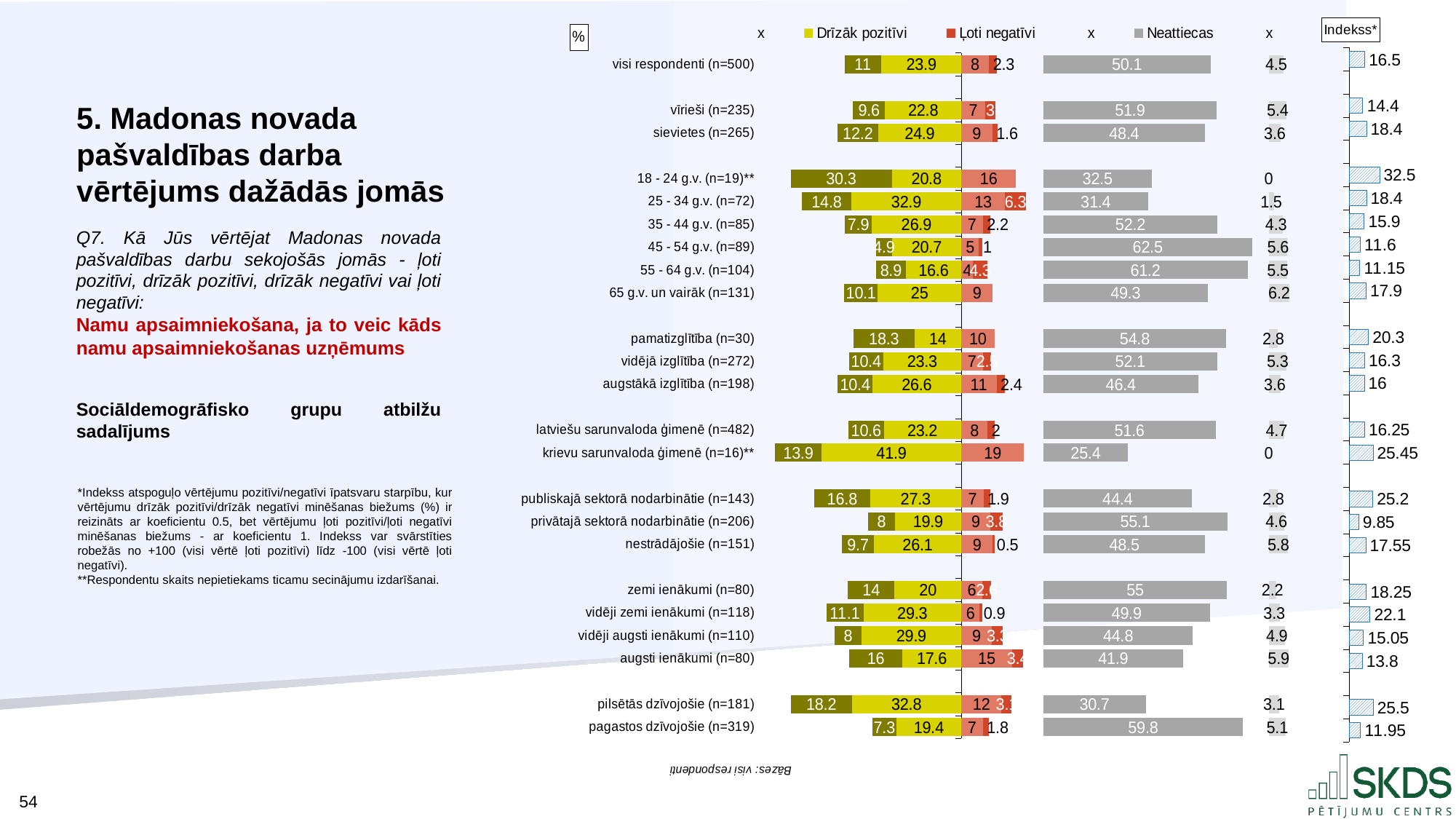
What is the Indekss value for pagastos dzīvojošie (n=319)? 11.95 What is the difference between the Neattiecas values for vīrieši (n=235) and sievietes (n=265)? 3.5 What is the Drīzāk pozitīvi value for visi respondenti (n=500)? 23.9 What kind of chart is shown on the slide? bar chart Which respondent group has the lowest Indekss value? privātajā sektorā nodarbinātie (n=206) Which respondent group has the highest Indekss value? 18 - 24 g.v. (n=19)** Which has the larger Drīzāk pozitīvi value: pilsētās dzīvojošie (n=181) or pagastos dzīvojošie (n=319)? pilsētās dzīvojošie (n=181) How many respondent groups are shown in the chart? 23 Which respondent group has the highest Neattiecas value? 45 - 54 g.v. (n=89) What is the Neattiecas value for visi respondenti (n=500)? 50.1 Which respondent group has the lowest Neattiecas value? krievu sarunvaloda ģimenē (n=16)** Which respondent group has the highest Drīzāk pozitīvi value? krievu sarunvaloda ģimenē (n=16)**